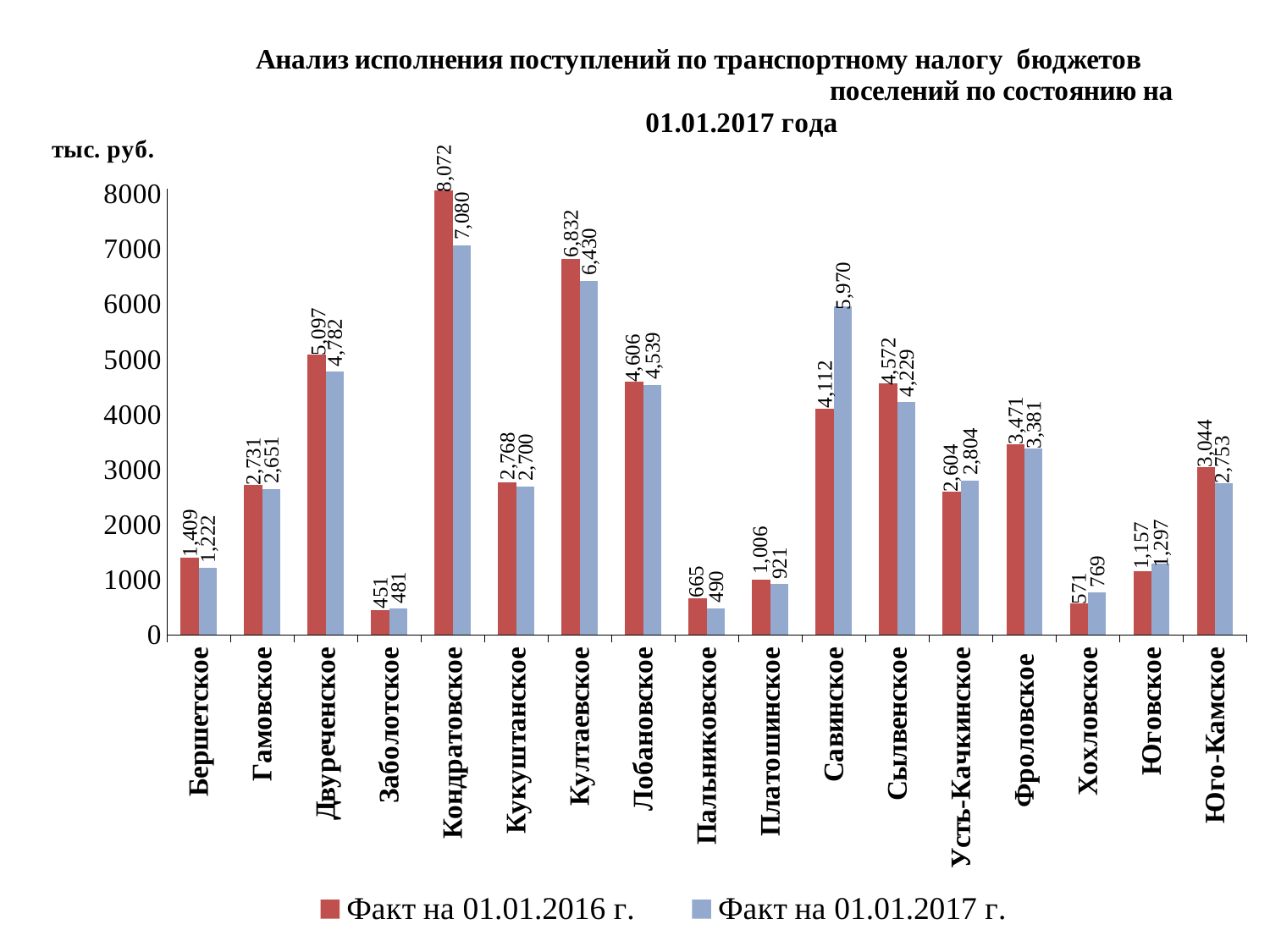
Which settlement has the highest value in the series Факт на 01.01.2016 г.? Кондратовское What is the value for Савинское in the series Факт на 01.01.2017 г.? 5,970 How many series does the legend list? 2 What kind of chart is shown on the slide? bar chart What is the value for Кондратовское in the series Факт на 01.01.2016 г.? 8,072 Is the value for Култаевское in the series Факт на 01.01.2017 г. greater or less than 6000? greater For Савинское, which series has the larger value: Факт на 01.01.2016 г. or Факт на 01.01.2017 г.? Факт на 01.01.2017 г. What is the difference between the 2016 and 2017 values for Пальниковское? 175 How many settlements are shown on the x axis? 17 What unit is shown on the y axis label? тыс. руб. What is the difference between the 2016 and 2017 values for Кондратовское? 992 Which settlement has the lowest value in the series Факт на 01.01.2016 г.? Заболотское